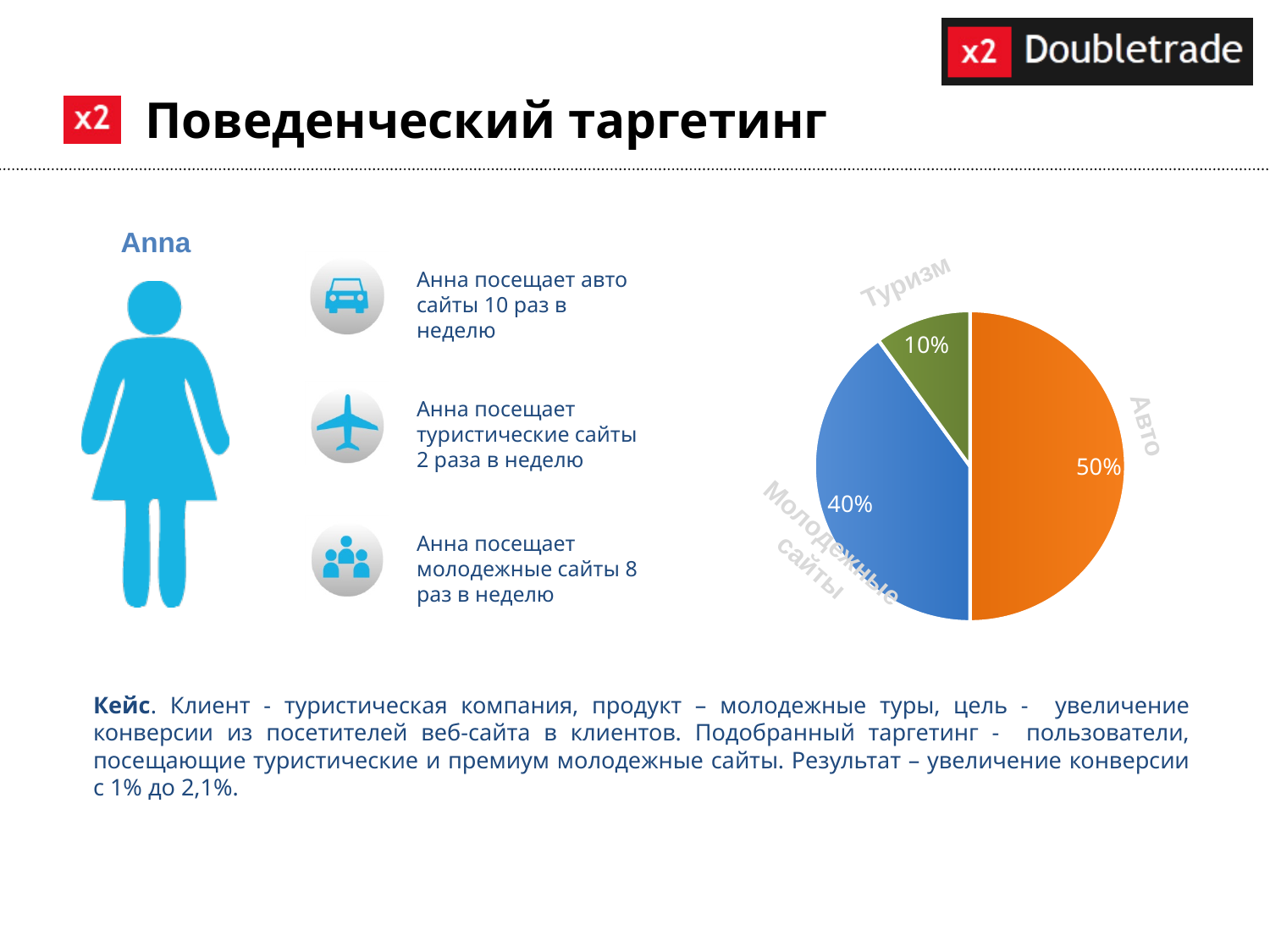
Which is larger, the Молодежные сайты slice or the Туризм slice? Молодежные сайты Which slice of the pie is the largest? Авто What is the difference in percentage points between the Авто slice and the Молодежные сайты slice? 10 What share of the pie does the Туризм slice have? 10% What share of the pie does the Авто slice have? 50% What kind of chart is shown on the slide? pie chart What is the difference in percentage points between the Авто slice and the Туризм slice? 40 What colour is the Авто slice of the pie? orange What colour is the Туризм slice of the pie? green How many slices does the pie chart have? 3 What share of the pie does the Молодежные сайты slice have? 40% Which slice of the pie is the smallest? Туризм